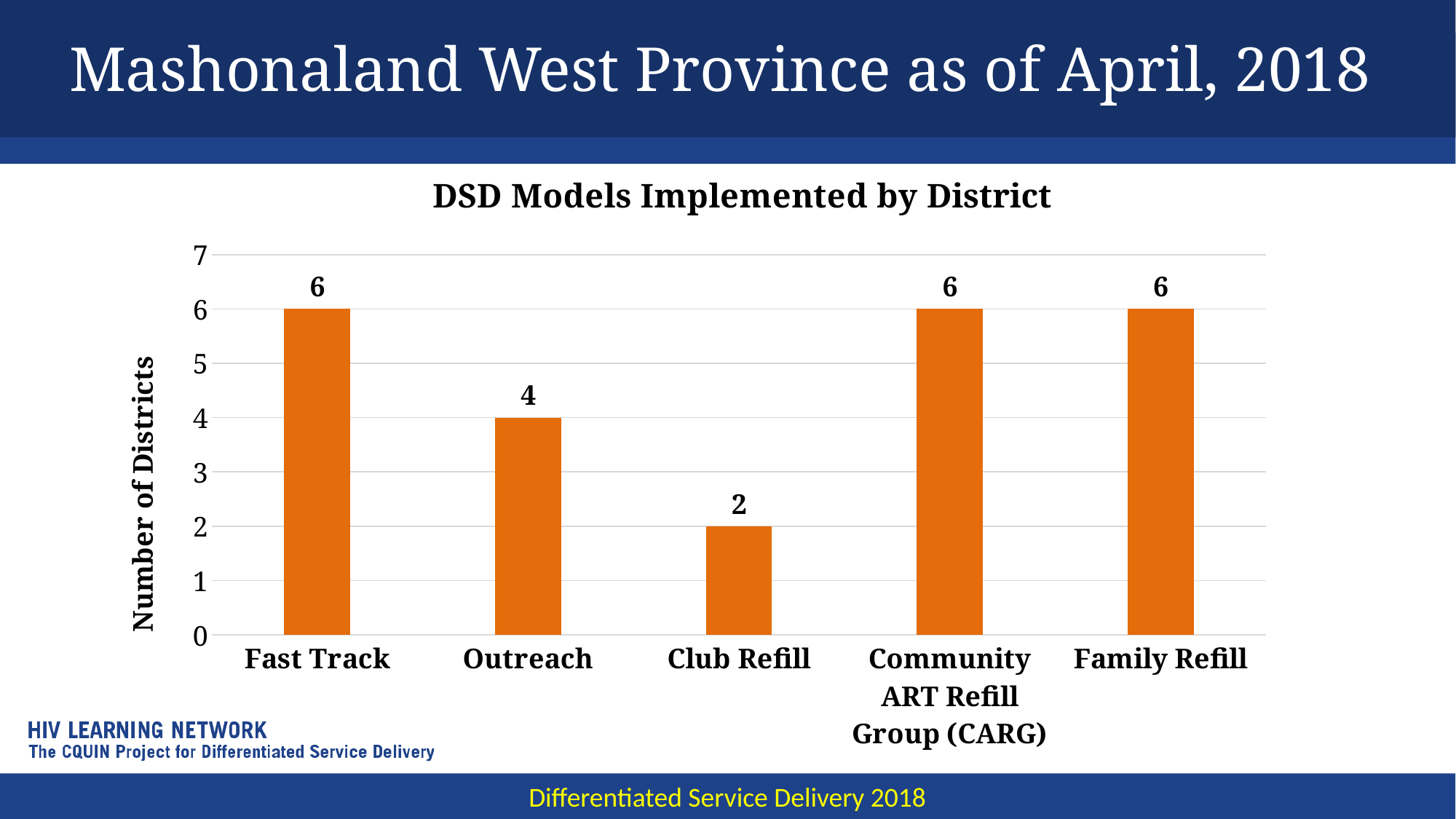
What is the difference in number of districts between Fast Track and Club Refill? 4 What is the label of the y axis? Number of Districts Is the value for Outreach greater or less than 3? greater What is the difference in number of districts between Outreach and Club Refill? 2 Which has more districts, Outreach or Family Refill? Family Refill What is the number of districts for Club Refill? 2 What is the number of districts for Community ART Refill Group (CARG)? 6 What is the number of districts for Outreach? 4 What is the title of the chart? DSD Models Implemented by District Which DSD model has the lowest number of districts? Club Refill How many DSD models are shown on the x axis? 5 What kind of chart is shown on the slide? Bar chart